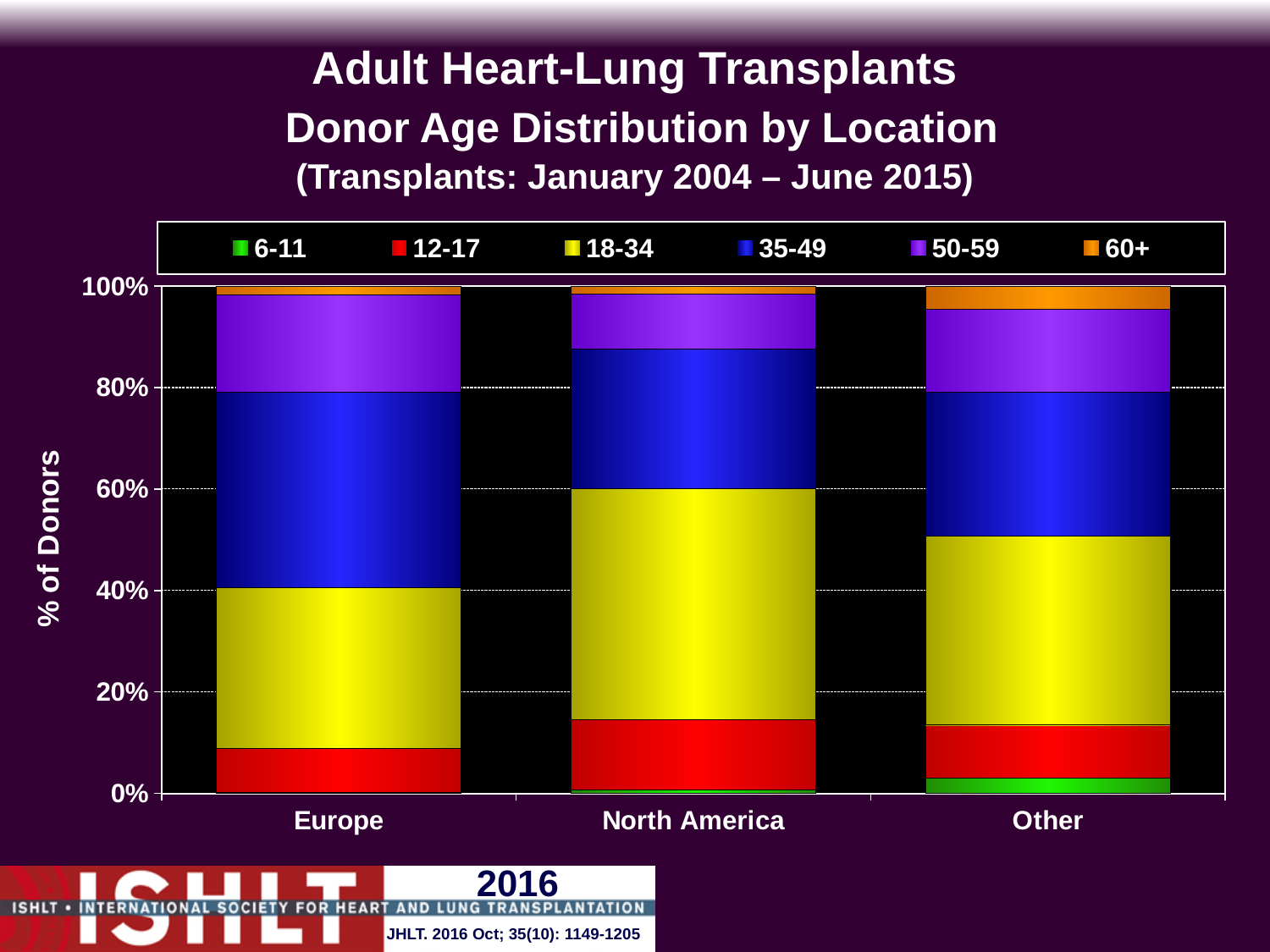
Is the 12-17 share of donors for Europe greater or less than 20%? less Which location has the smallest 50-59 segment? North America How many locations are shown on the x axis of the chart? 3 Is the 50-59 segment larger for Europe or for North America? Europe What kind of chart is shown on the slide? Stacked bar chart Is the 6-11 segment larger for Other or for Europe? Other What is the label of the y axis? % of Donors Which location has the largest 18-34 segment? North America Is the 18-34 share of donors for North America greater or less than 40%? greater What transplant period is given in the chart title? January 2004 – June 2015 How many donor age groups does the legend list? 6 Which location has the largest 35-49 segment? Europe